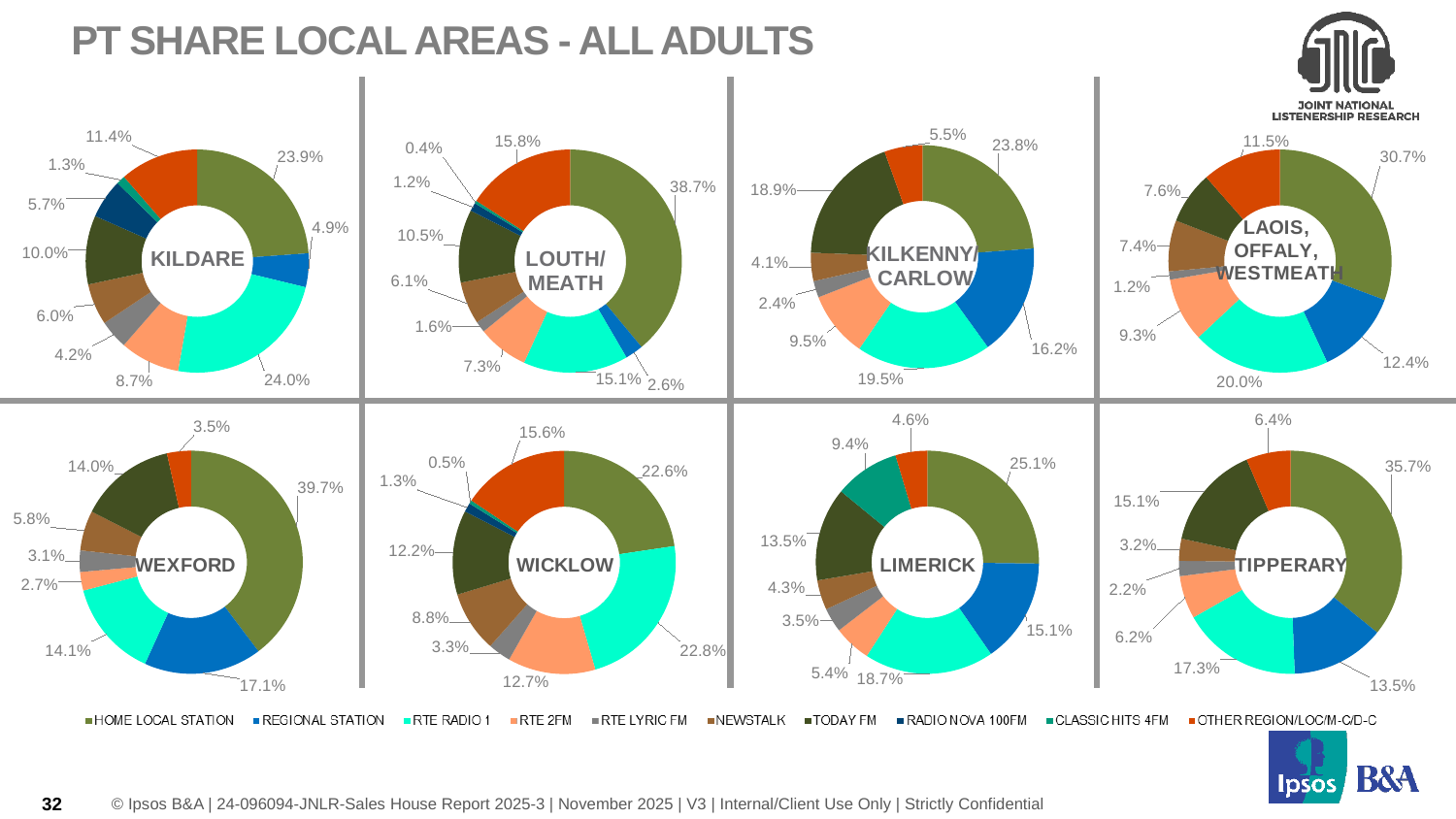
In the TIPPERARY chart, what is the share for HOME LOCAL STATION? 35.7% In the LIMERICK chart, what is the share for CLASSIC HITS 4FM? 9.4% In the KILKENNY/CARLOW chart, what is the difference between the HOME LOCAL STATION share (23.8%) and the REGIONAL STATION share (16.2%)? 7.6% What kind of charts are shown on the slide? Pie (donut) charts In the LOUTH/MEATH chart, what is the share of the smallest slice? 0.4% In the WICKLOW chart, which is larger: the HOME LOCAL STATION share or the RTE RADIO 1 share? RTE RADIO 1 (22.8%) What is the title of the slide? PT SHARE LOCAL AREAS - ALL ADULTS How many series does the legend list? 10 In the LAOIS, OFFALY, WESTMEATH chart, what is the share for RTE RADIO 1? 20.0% How many local-area charts are shown on the slide? 8 In the WEXFORD chart, what is the share of the largest slice? 39.7% In the KILDARE chart, what is the share for RTE RADIO 1? 24.0%